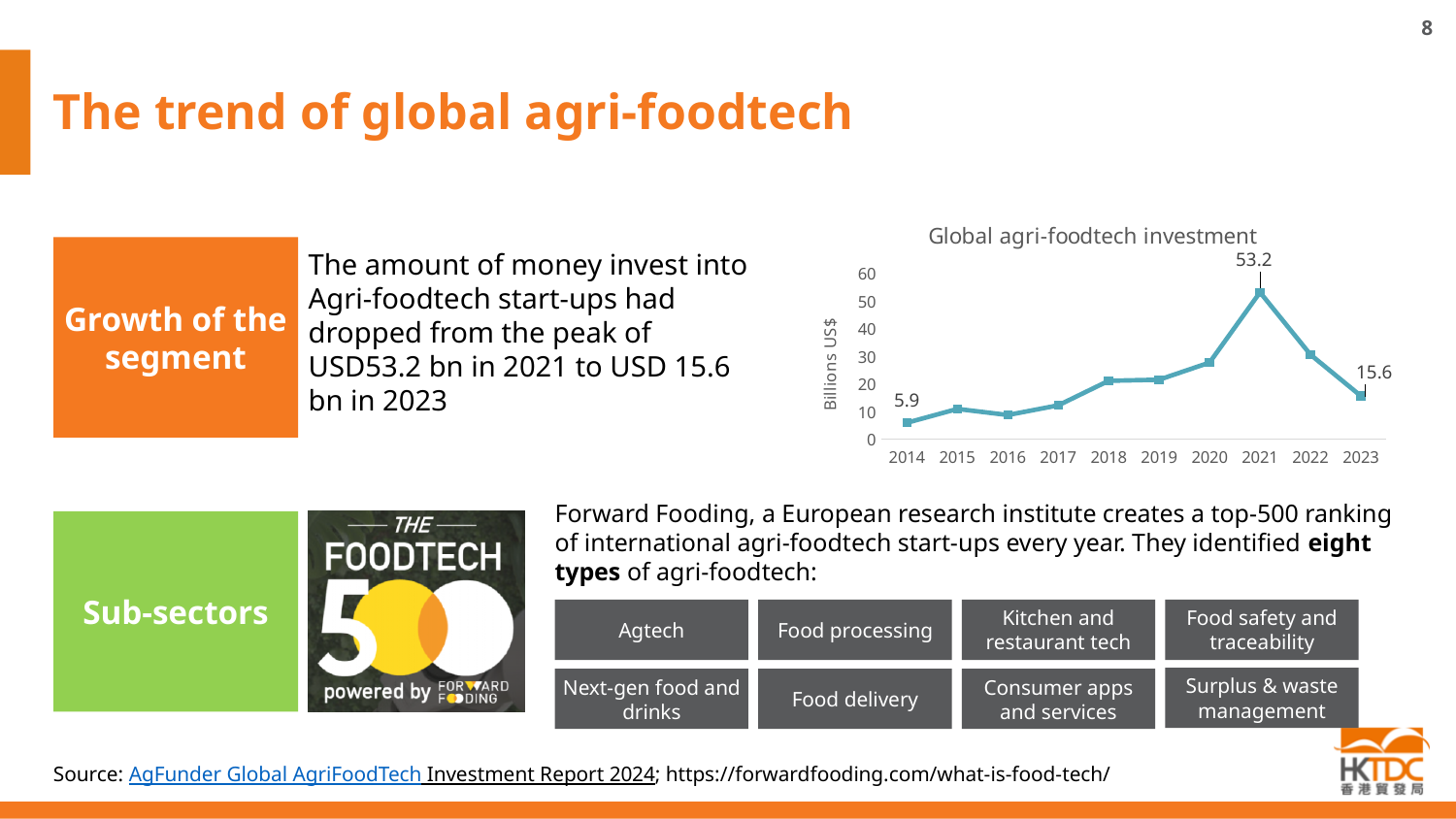
What is the value for 2021 in the Global agri-foodtech investment chart? 53.2 Is the value for 2022 in the Global agri-foodtech investment chart greater or less than 40? less Which year has the highest global agri-foodtech investment in the chart? 2021 What is the value for 2014 in the Global agri-foodtech investment chart? 5.9 Which year has the lowest global agri-foodtech investment in the chart? 2014 How many years are plotted in the Global agri-foodtech investment chart? 10 Is the value for 2017 in the Global agri-foodtech investment chart greater or less than 10? greater What kind of chart is the Global agri-foodtech investment chart? line chart What is the difference between the 2021 and 2023 values in the Global agri-foodtech investment chart? 37.6 Do the values in the Global agri-foodtech investment chart rise or fall from 2021 to 2023? fall What is the value for 2023 in the Global agri-foodtech investment chart? 15.6 Which year has a larger value in the Global agri-foodtech investment chart, 2021 or 2023? 2021